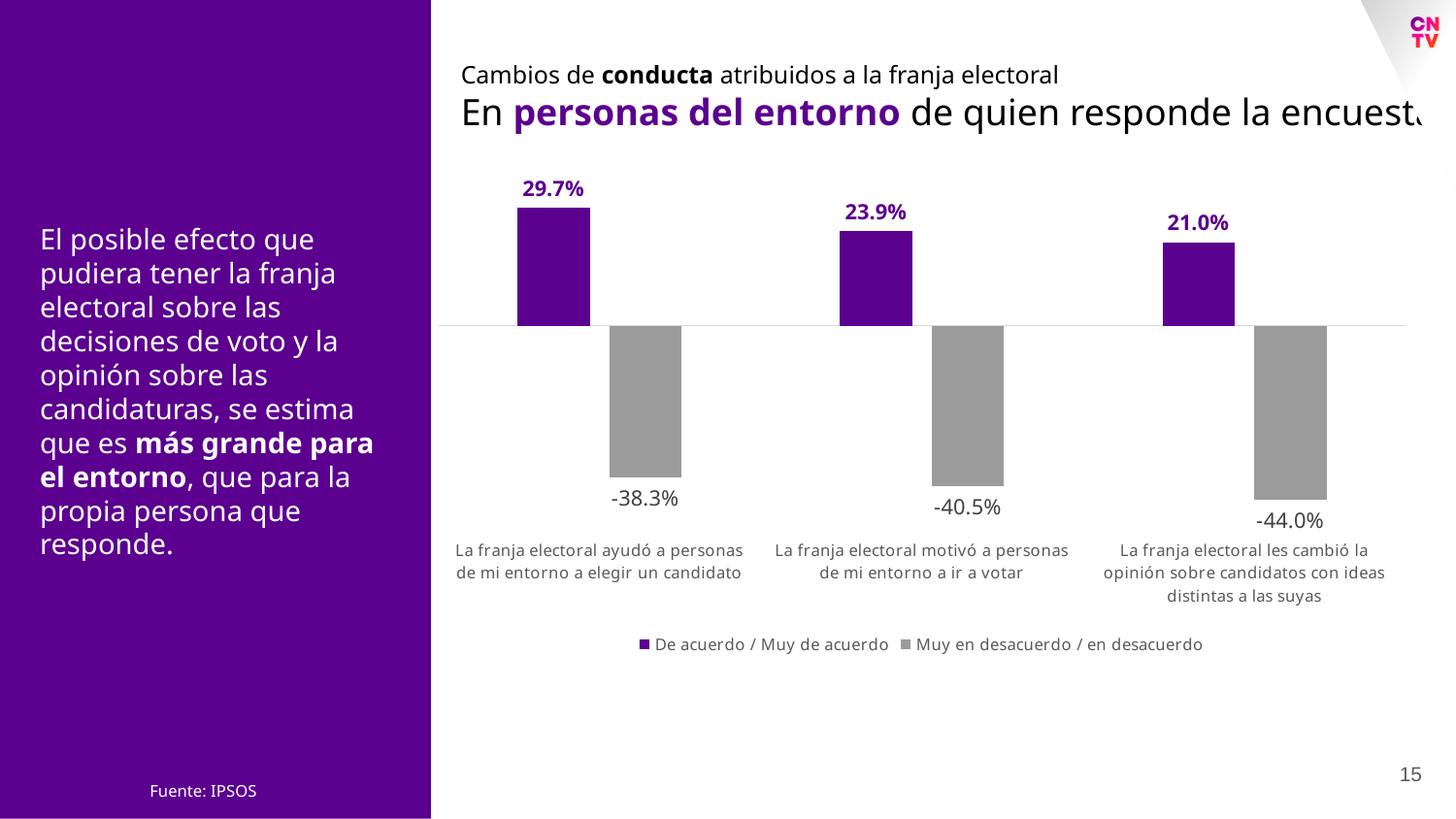
What is the difference between the 'De acuerdo / Muy de acuerdo' values for 'ayudó a personas de mi entorno a elegir un candidato' and 'motivó a personas de mi entorno a ir a votar'? 5.8 percentage points What colour represents the 'Muy en desacuerdo / en desacuerdo' series in the chart? Grey Which is larger in magnitude: the disagreement value for 'ayudó a personas de mi entorno a elegir un candidato' or for 'les cambió la opinión sobre candidatos con ideas distintas a las suyas'? La franja electoral les cambió la opinión sobre candidatos con ideas distintas a las suyas How many categories are shown on the x axis of the chart? 3 What is the 'Muy en desacuerdo / en desacuerdo' value for 'La franja electoral motivó a personas de mi entorno a ir a votar'? -40.5% What is the 'De acuerdo / Muy de acuerdo' value for 'La franja electoral les cambió la opinión sobre candidatos con ideas distintas a las suyas'? 21.0% What type of chart is shown on the slide? Bar chart Do the 'De acuerdo / Muy de acuerdo' values rise or fall from left to right across the categories? Fall Which category has the highest 'De acuerdo / Muy de acuerdo' value? La franja electoral ayudó a personas de mi entorno a elegir un candidato How many series does the chart legend list? 2 What percentage of respondents agree or strongly agree that the electoral broadcast helped people in their circle choose a candidate? 29.7% Which category has the lowest 'De acuerdo / Muy de acuerdo' value? La franja electoral les cambió la opinión sobre candidatos con ideas distintas a las suyas